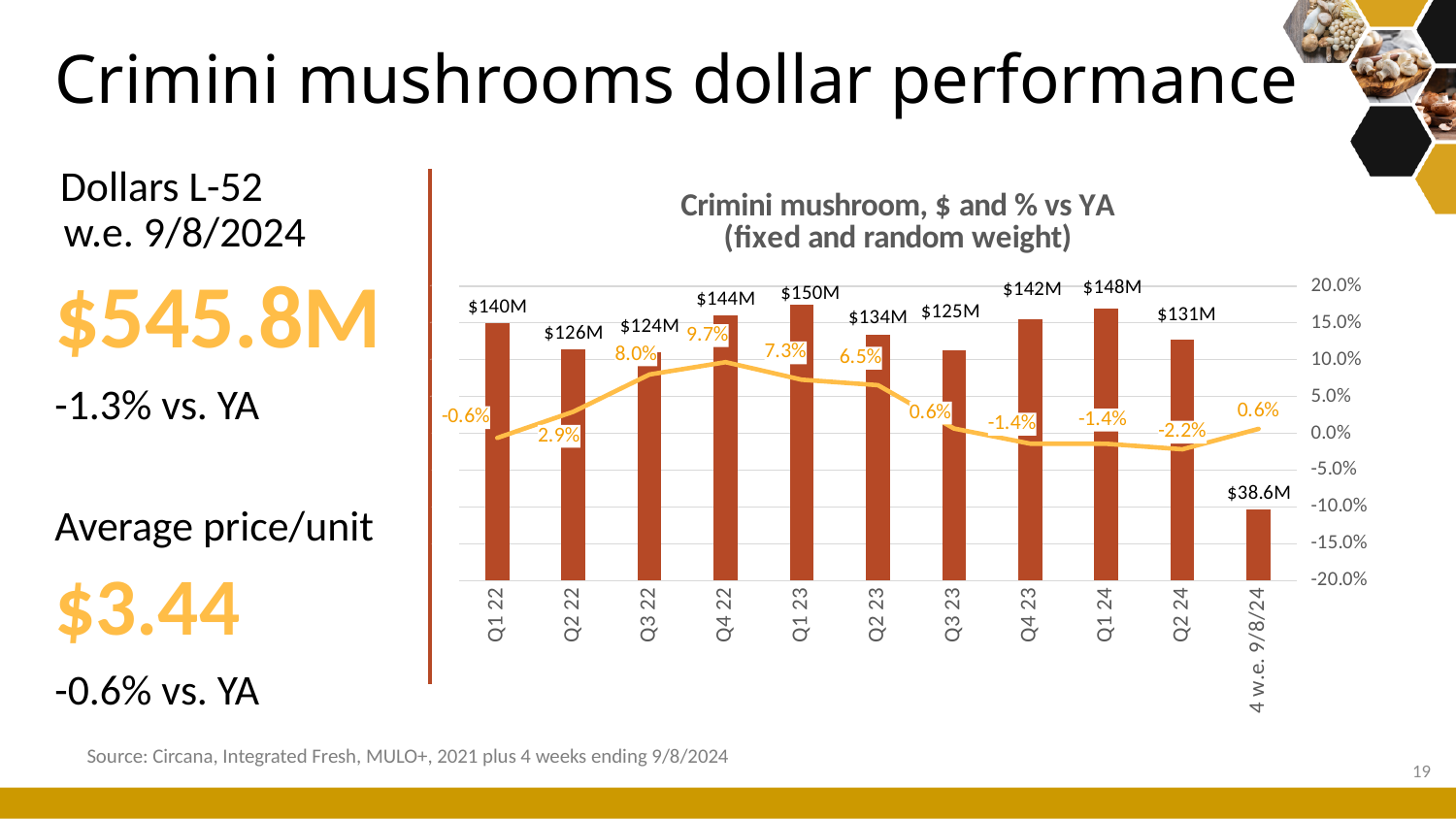
Which period has the highest % vs YA value? Q4 22 What kind of chart is this? Combination bar and line chart Which period has the highest dollar value? Q1 23 Which is larger, the dollar value for Q4 23 or for Q2 24? Q4 23 What is the % vs YA value shown for Q2 24? -2.2% Does the % vs YA line rise or fall from Q1 22 to Q4 22? Rise How many periods are shown on the x axis? 11 What is the difference in dollar value between Q1 23 and Q1 22? $10M Which period has the lowest dollar value? 4 w.e. 9/8/24 What is the dollar value shown for Q1 23? $150M What is the dollar value shown for the 4 w.e. 9/8/24 period? $38.6M What is the % vs YA value shown for Q4 22? 9.7%